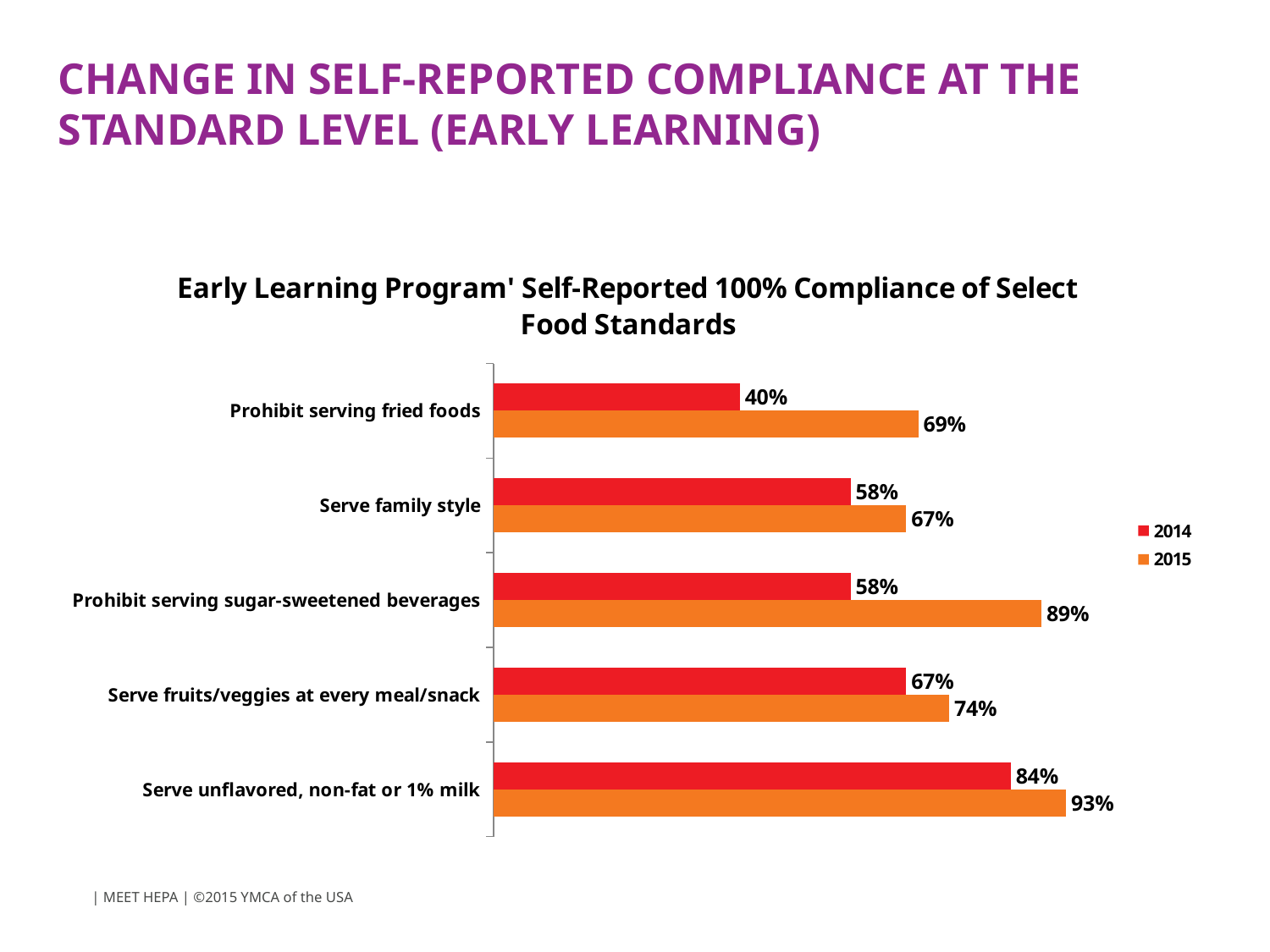
What is the 2015 value for Prohibit serving sugar-sweetened beverages? 89% What is the 2015 value for Serve fruits/veggies at every meal/snack? 74% What is the 2014 value for Prohibit serving fried foods? 40% What kind of chart is shown on the slide? Bar chart What is the difference between the 2015 and 2014 values for Prohibit serving sugar-sweetened beverages? 31% Which category has the highest 2015 value? Serve unflavored, non-fat or 1% milk How many categories are shown in the chart? 5 Which series is shown in orange? 2015 How many series does the legend list? 2 What is the difference between the 2015 and 2014 values for Serve family style? 9% Which is larger: the 2015 value for Prohibit serving fried foods or the 2015 value for Serve family style? Prohibit serving fried foods Which category has the lowest 2014 value? Prohibit serving fried foods